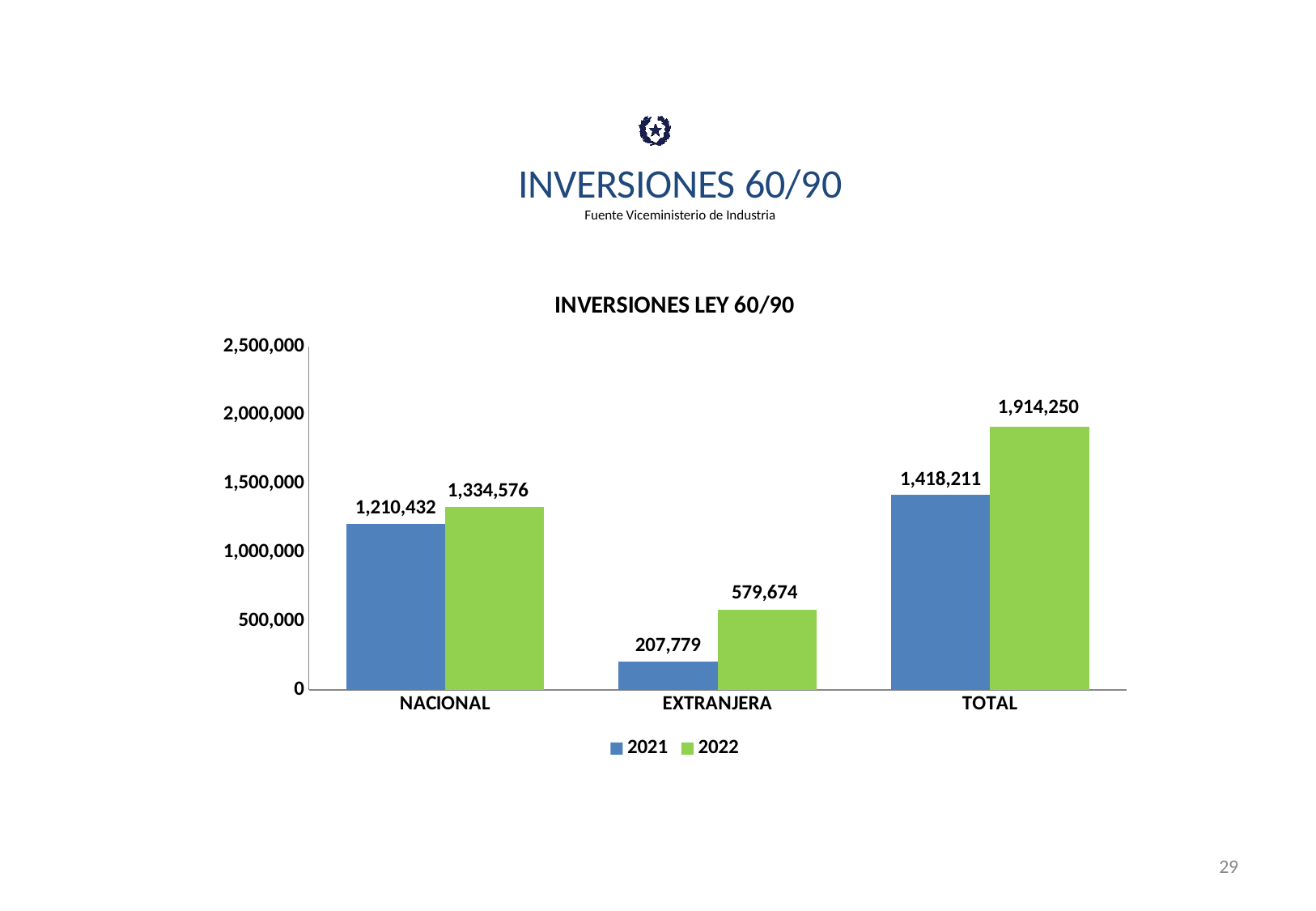
Which category has the lowest 2021 value? EXTRANJERA What is the difference between the 2022 and 2021 values for TOTAL? 496,039 What is the 2022 value for TOTAL? 1,914,250 How many categories are shown on the x axis? 3 How many series does the legend list? 2 Which category has the highest 2022 value? TOTAL What kind of chart is shown on the slide? bar chart What is the 2022 value for EXTRANJERA? 579,674 Is the 2021 value for EXTRANJERA greater or less than 500,000? less What is the 2021 value for NACIONAL? 1,210,432 Which is larger for NACIONAL, the 2021 value or the 2022 value? 2022 What is the difference between the 2022 and 2021 values for EXTRANJERA? 371,895